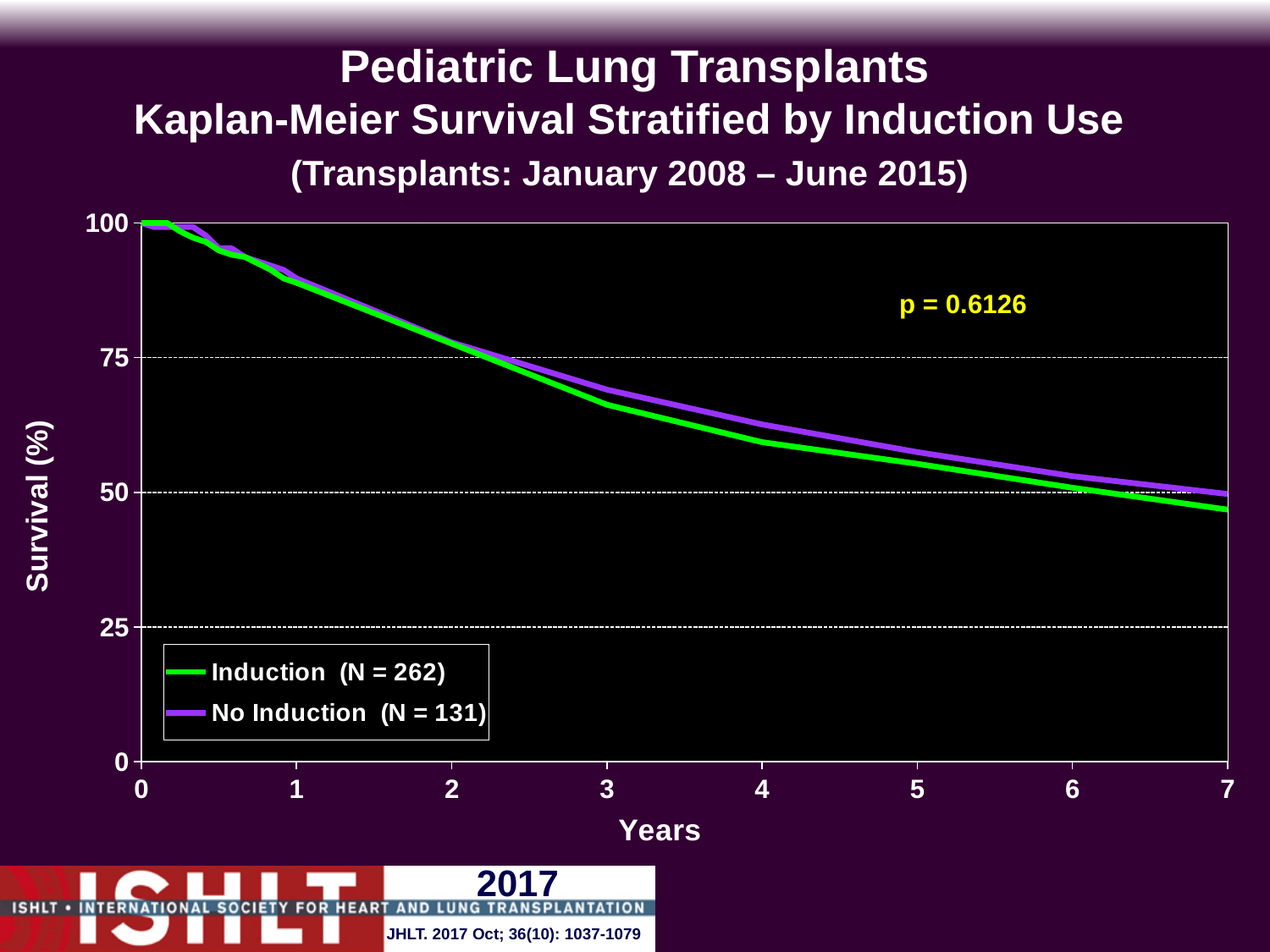
Is the survival value for the No Induction group at 1 year greater or less than 75? greater Is the survival value for the No Induction group at 5 years greater or less than 75? less What p-value is printed on the chart? p = 0.6126 How many series does the legend list? 2 What is the survival (%) for the Induction group at year 0? 100 What kind of chart is shown on the slide? line chart Is the survival value for the Induction group at 3 years greater or less than 75? less Do the survival curves rise or fall as years increase? fall What are the two series named in the legend? Induction (N = 262) and No Induction (N = 131) How many years does the x axis span, from its first to its last tick? 0 to 7 At 5 years, which group has the higher survival, Induction or No Induction? No Induction